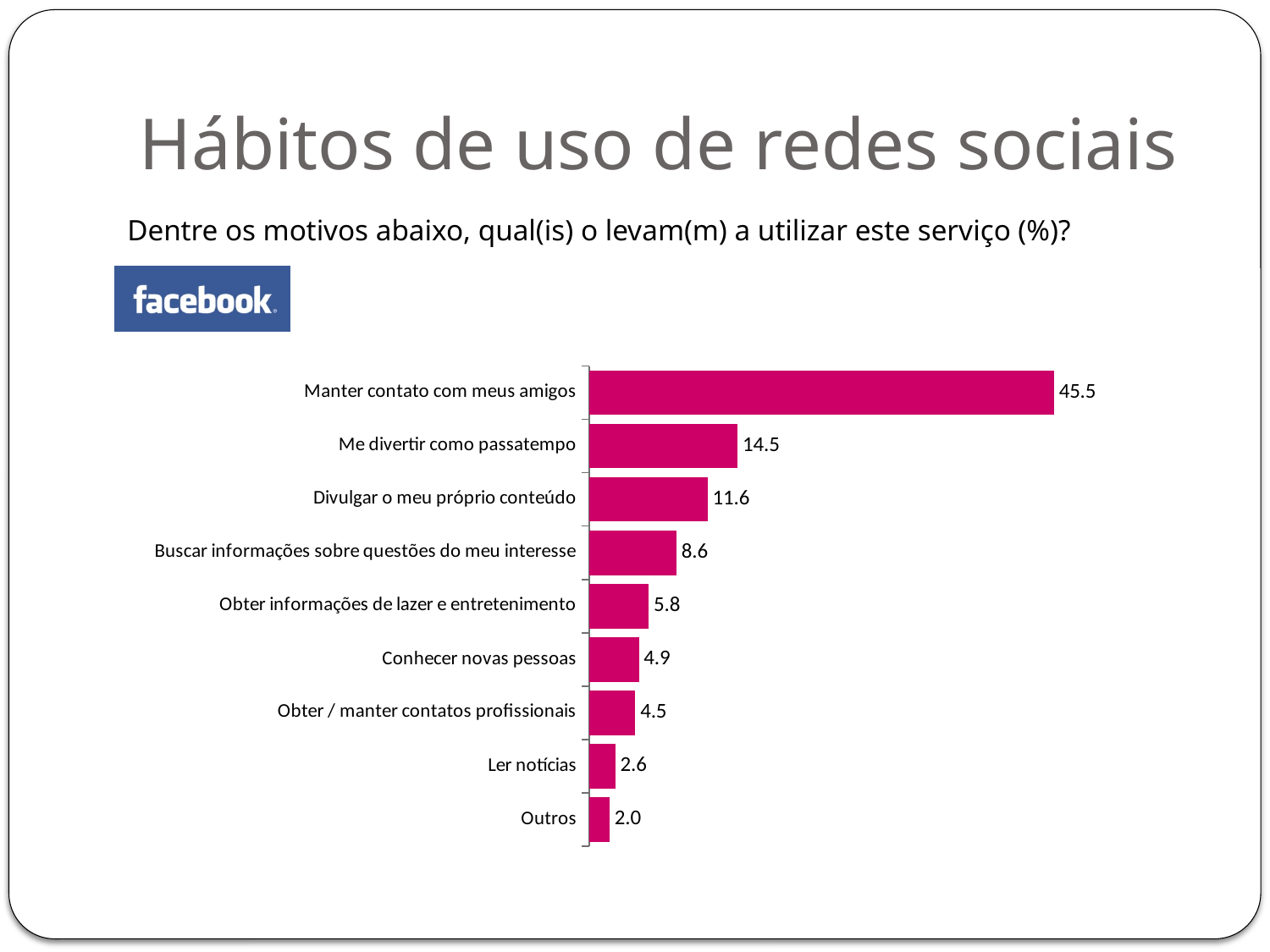
Which is larger: "Conhecer novas pessoas" or "Obter / manter contatos profissionais"? Conhecer novas pessoas What is the value for "Divulgar o meu próprio conteúdo"? 11.6 What kind of chart is shown on the slide? Bar chart What is the difference between "Manter contato com meus amigos" and "Me divertir como passatempo"? 31.0 How many categories are shown in the chart? 9 What is the value for "Obter / manter contatos profissionais"? 4.5 Which social network logo appears above the chart? facebook Which category has the highest value? Manter contato com meus amigos What is the difference between "Buscar informações sobre questões do meu interesse" and "Obter informações de lazer e entretenimento"? 2.8 What is the value for "Manter contato com meus amigos"? 45.5 What is the value for "Ler notícias"? 2.6 Which category has the lowest value? Outros